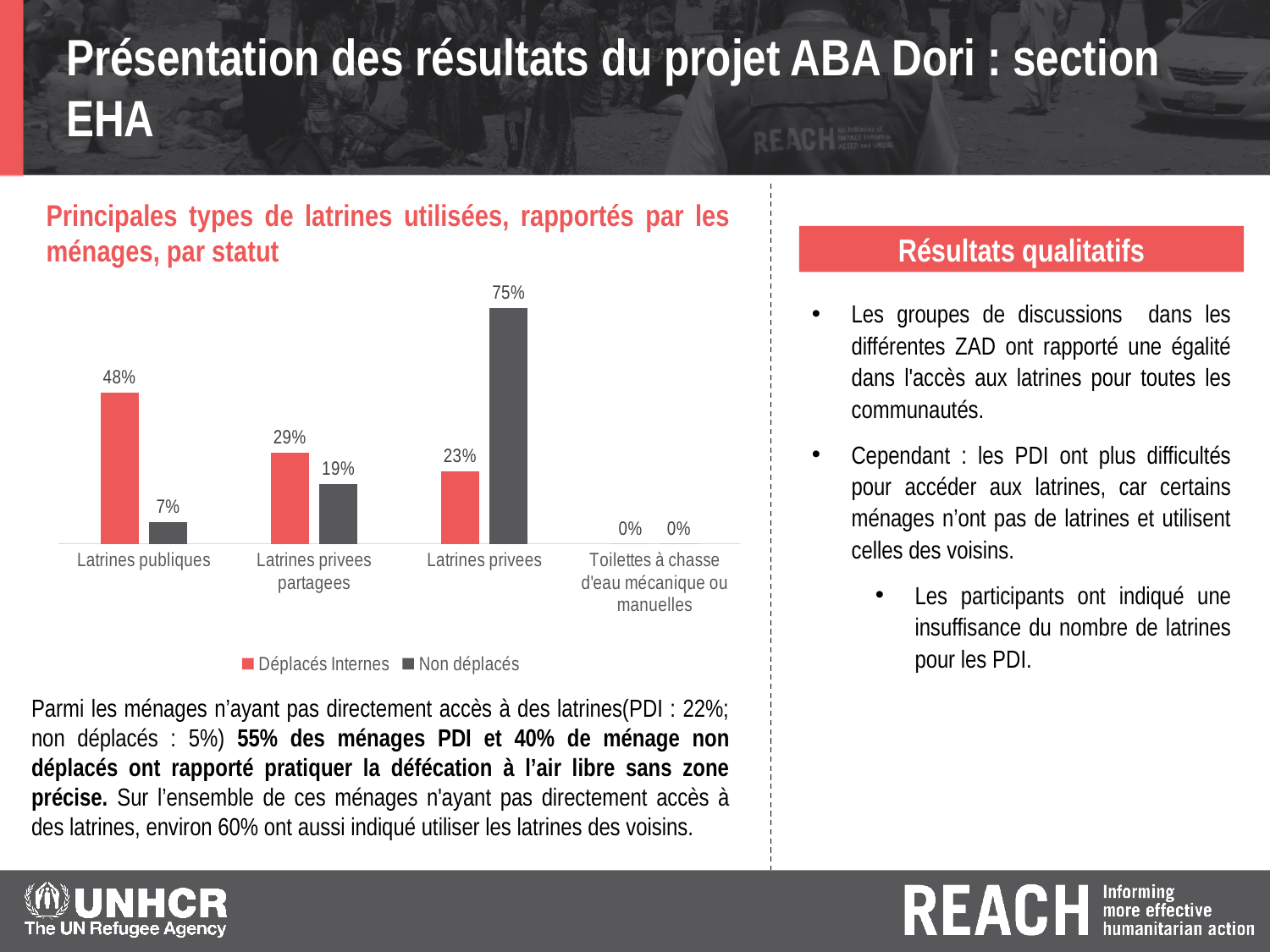
Which latrine type has the lowest value for the Déplacés Internes series? Toilettes à chasse d'eau mécanique ou manuelles What percentage of Déplacés Internes households reported using Latrines publiques? 48% What is the difference between the Déplacés Internes and Non déplacés values for Latrines publiques? 41 percentage points What is the difference between the Non déplacés and Déplacés Internes values for Latrines privees? 52 percentage points How many series does the legend list? 2 What kind of chart is used to show the types of latrines by status? Bar chart What percentage of Non déplacés households reported using Latrines privees? 75% How many latrine type categories are shown on the x axis? 4 Which colour represents the Déplacés Internes series in the chart? Red What is the value for Non déplacés in the Latrines privees partagees category? 19% For Latrines privees partagees, which series has the larger value, Déplacés Internes or Non déplacés? Déplacés Internes Which latrine type has the highest value for the Non déplacés series? Latrines privees